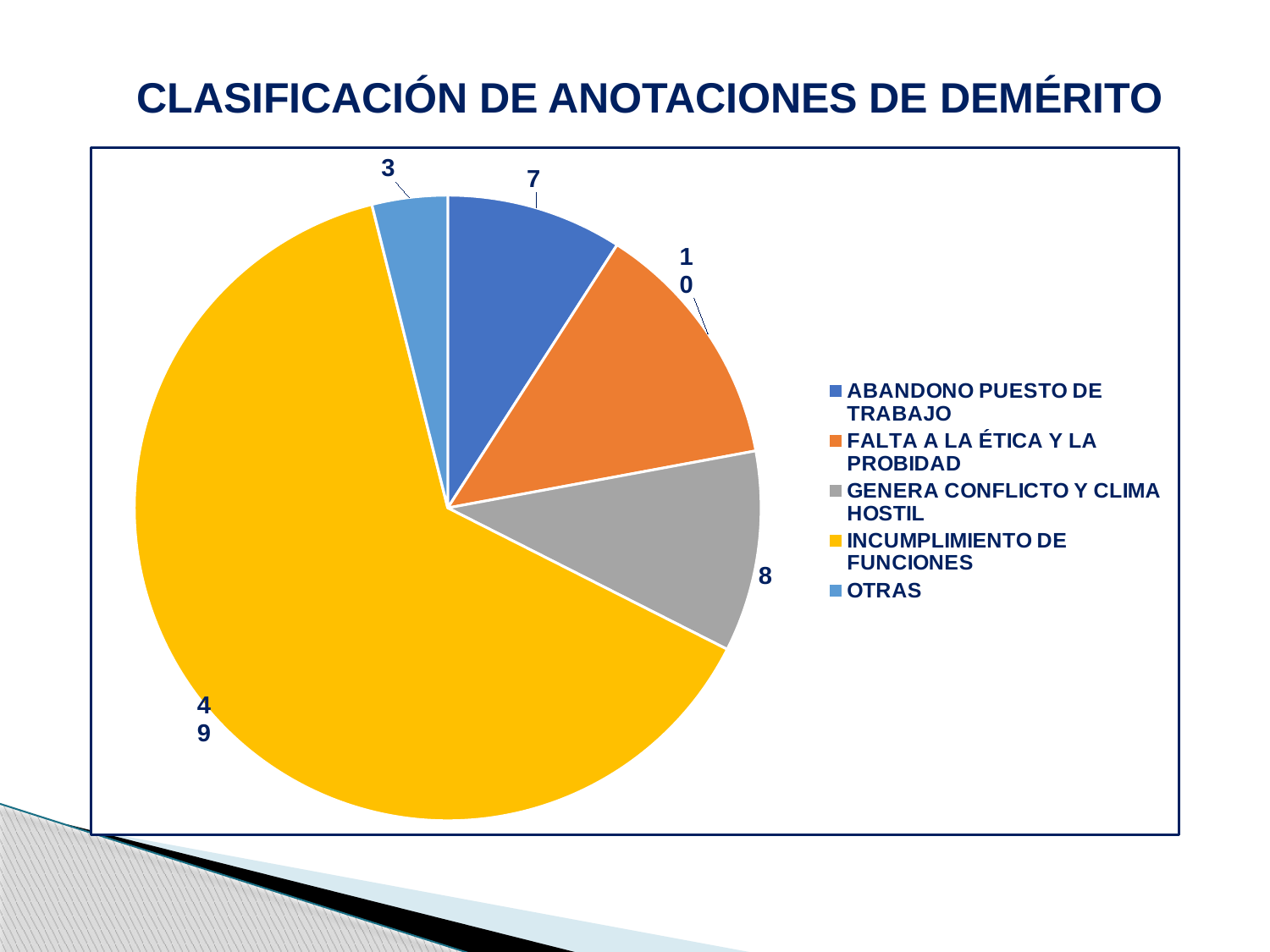
What is the value for INCUMPLIMIENTO DE FUNCIONES? 49 What kind of chart is shown on the slide? Pie chart What is the title of the chart? CLASIFICACIÓN DE ANOTACIONES DE DEMÉRITO What is the value for FALTA A LA ÉTICA Y LA PROBIDAD? 10 Which category has the largest slice of the pie? INCUMPLIMIENTO DE FUNCIONES What is the value for OTRAS? 3 How many categories are shown in the pie chart? 5 What is the value for ABANDONO PUESTO DE TRABAJO? 7 What is the difference between the values for INCUMPLIMIENTO DE FUNCIONES and FALTA A LA ÉTICA Y LA PROBIDAD? 39 Which is larger, the value for GENERA CONFLICTO Y CLIMA HOSTIL or the value for ABANDONO PUESTO DE TRABAJO? GENERA CONFLICTO Y CLIMA HOSTIL Which category has the smallest slice of the pie? OTRAS What is the total of all the slices in the pie chart? 77